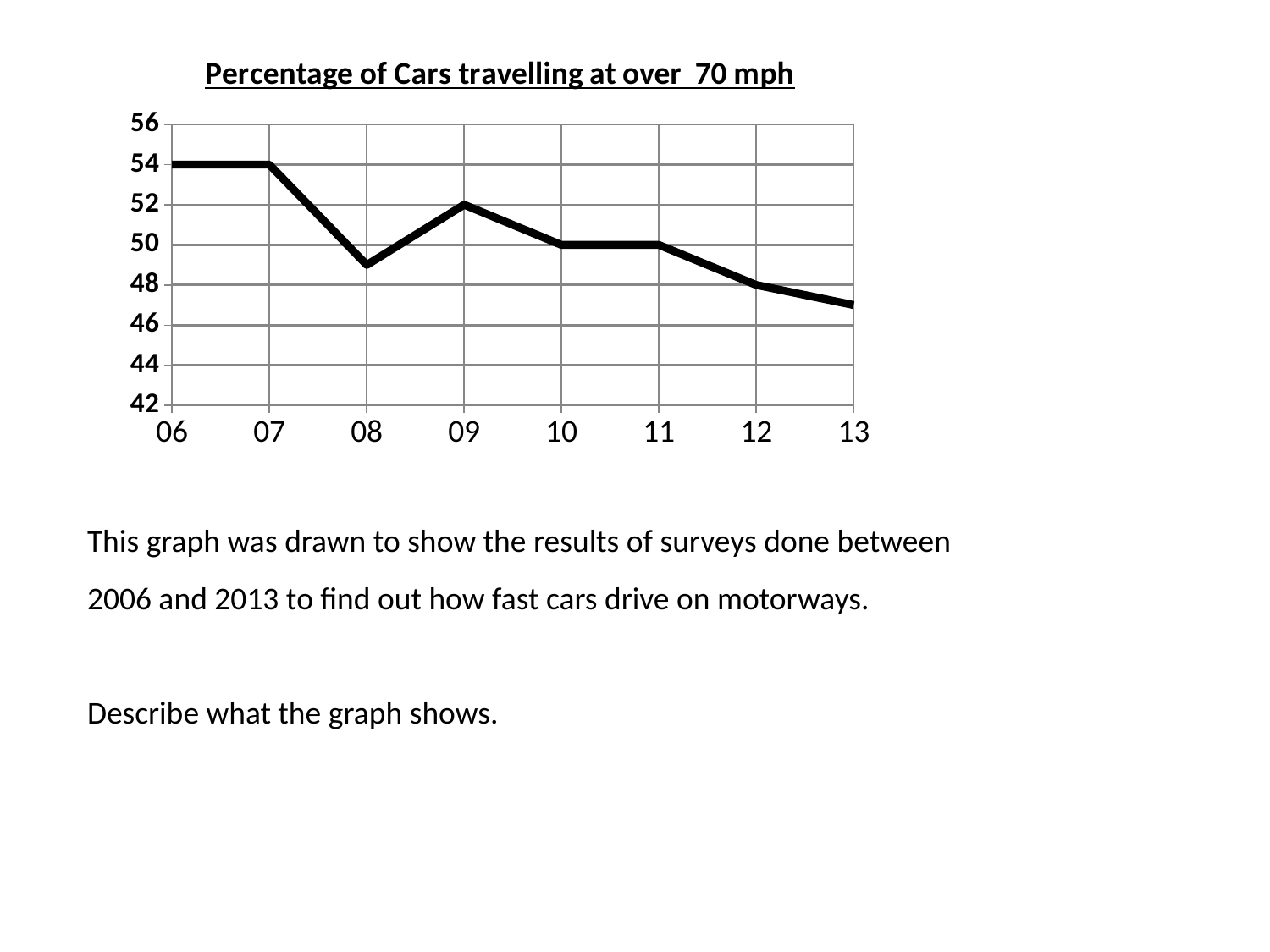
Which is larger, the value for 09 or the value for 10? 09 What is the value for 06? 54 What is the value for 11? 50 What is the title of the chart? Percentage of Cars travelling at over 70 mph Is the value for 08 greater or less than 50? less What is the value for 09? 52 What type of chart is shown on the slide? line chart Which year has the lowest value? 13 What is the difference between the values for 07 and 12? 6 What is the value for 12? 48 How many years are plotted on the x axis of the chart? 8 Overall, do the values rise or fall from 06 to 13? fall